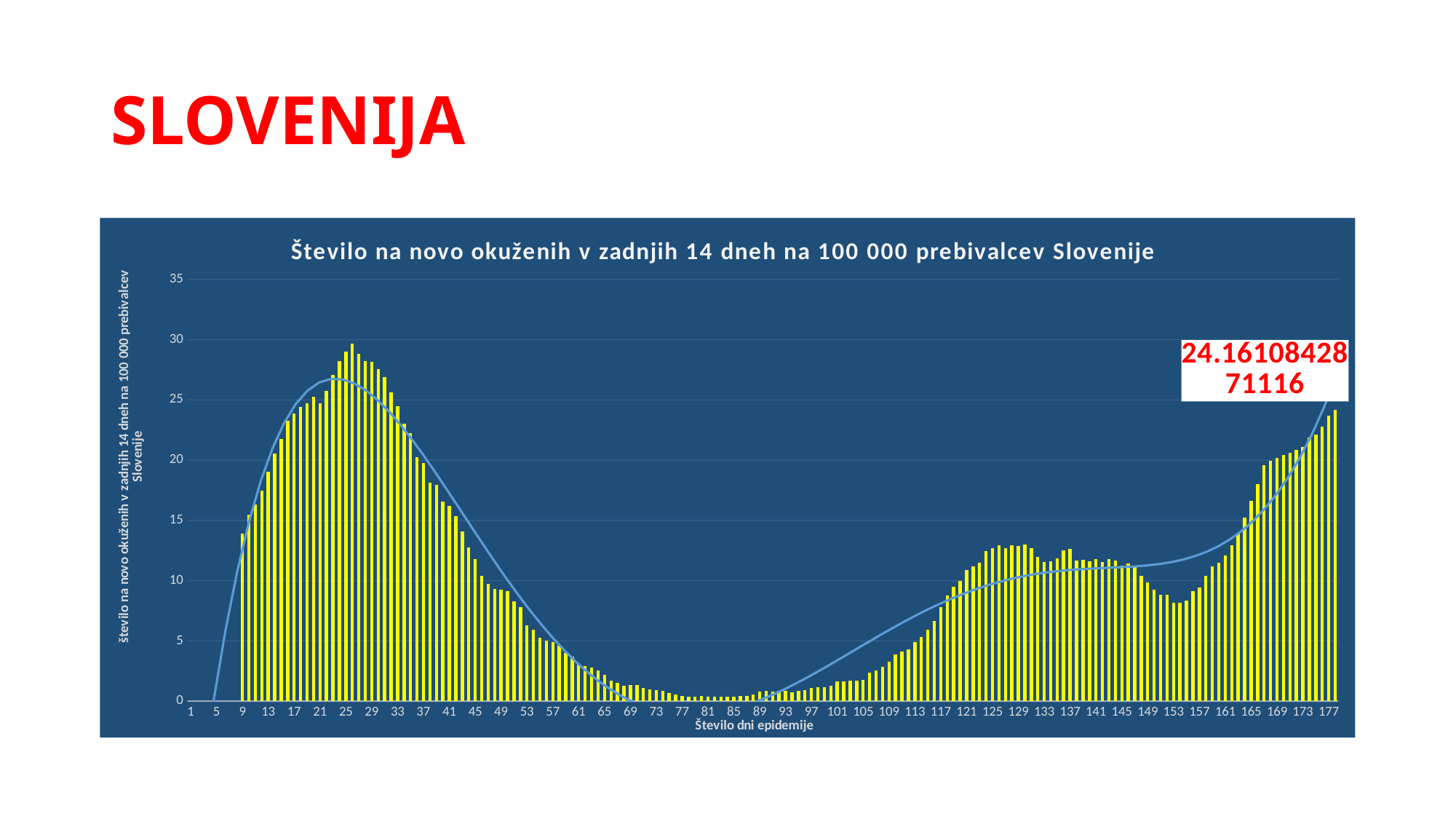
Is the value for day 25 greater or less than 25? greater What kind of chart is shown on the slide? bar chart Which is larger, the value for day 81 or the value for day 125? day 125 Is the value for day 125 greater or less than 10? greater Which is larger, the value for day 25 or the value for day 177? day 25 Is the value for day 177 greater or less than 20? greater Do the values rise or fall between day 29 and day 81? fall What is the label of the x axis? Število dni epidemije What value is printed in the data label at the right end of the chart? 24.1610842871116 What is the title of the chart? Število na novo okuženih v zadnjih 14 dneh na 100 000 prebivalcev Slovenije